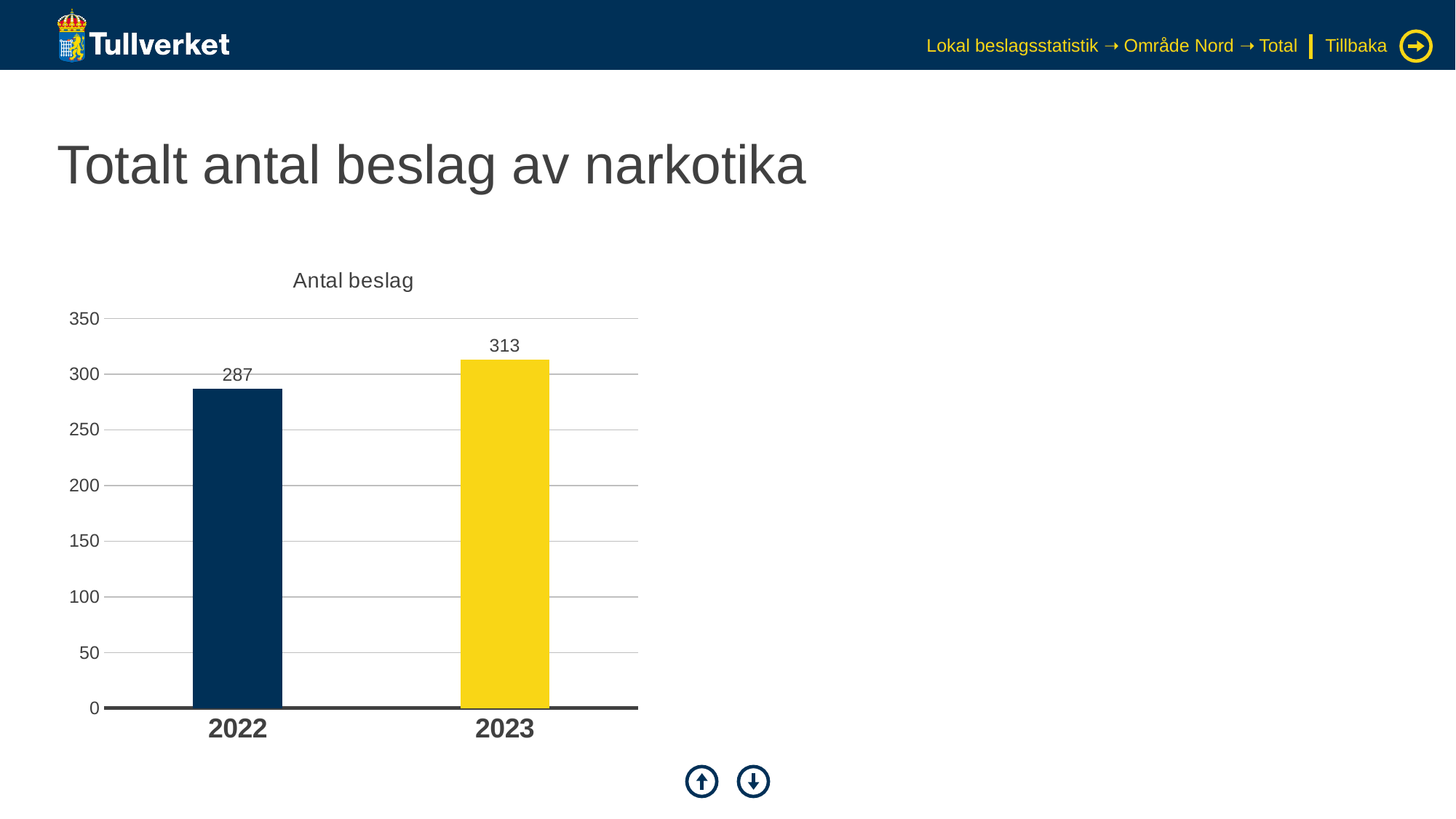
Do the values rise or fall from 2022 to 2023? rise Is the value for 2023 greater or less than 300? greater What is the value for 2023? 313 What kind of chart is shown? bar chart Which is larger, the value for 2022 or the value for 2023? 2023 What is the difference between the values for 2023 and 2022? 26 What is the title of the chart? Antal beslag What is the value for 2022? 287 How many categories are shown on the x axis? 2 Which year has the highest number of seizures? 2023 Is the value for 2022 greater or less than 300? less Which year has the lowest number of seizures? 2022